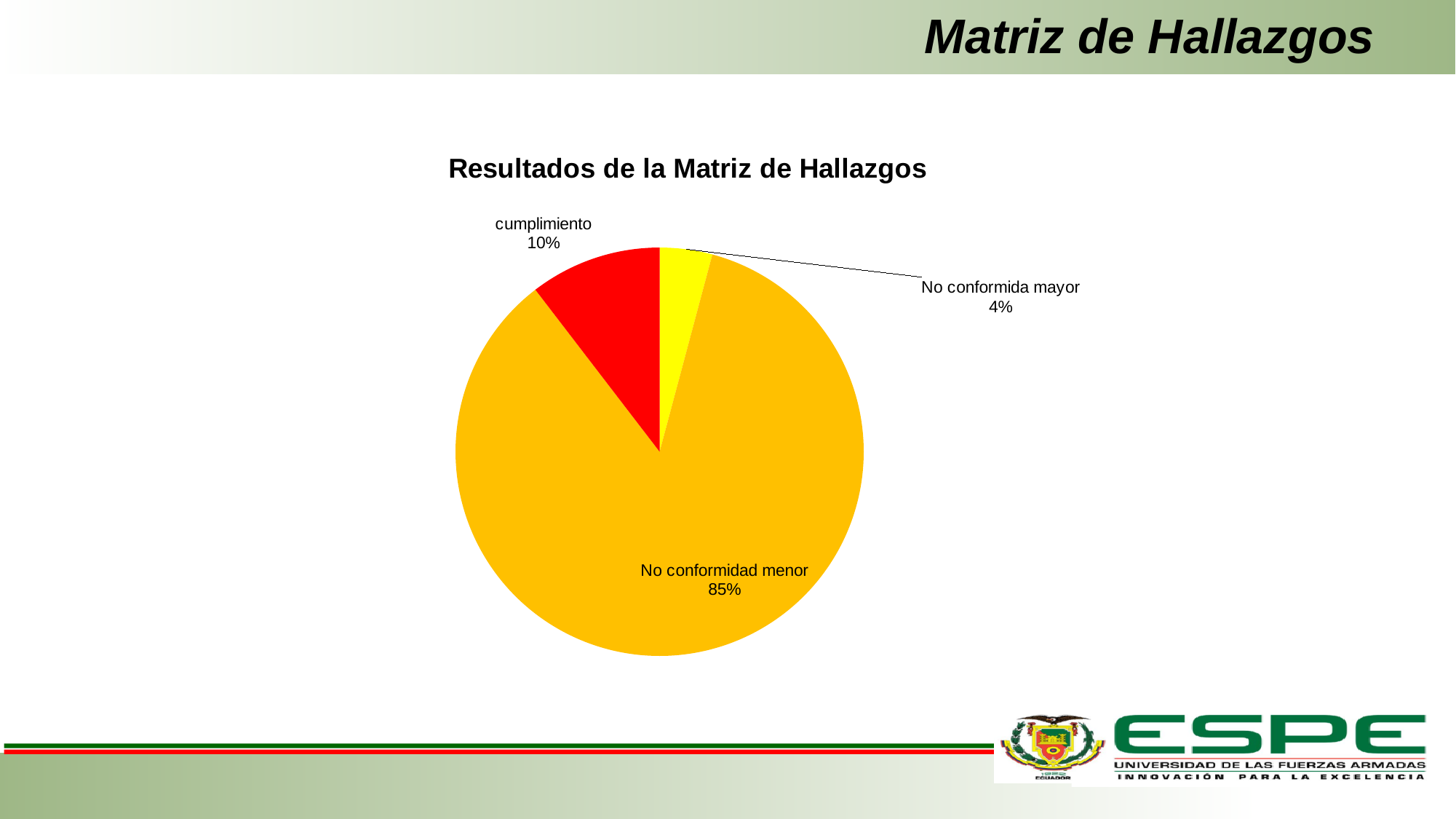
Which category has the smallest slice of the pie? No conformida mayor What share of the pie does "No conformidad menor" represent? 85% What share of the pie does "cumplimiento" represent? 10% What is the title of the chart? Resultados de la Matriz de Hallazgos What is the difference in percentage points between "cumplimiento" and "No conformida mayor"? 6% What kind of chart is shown on the slide? pie chart What colour is the "cumplimiento" slice? red Which is larger, the share for "cumplimiento" or the share for "No conformida mayor"? cumplimiento How many slices does the pie chart have? 3 What share of the pie does "No conformida mayor" represent? 4% Which category has the largest slice of the pie? No conformidad menor What is the difference in percentage points between "No conformidad menor" and "cumplimiento"? 75%